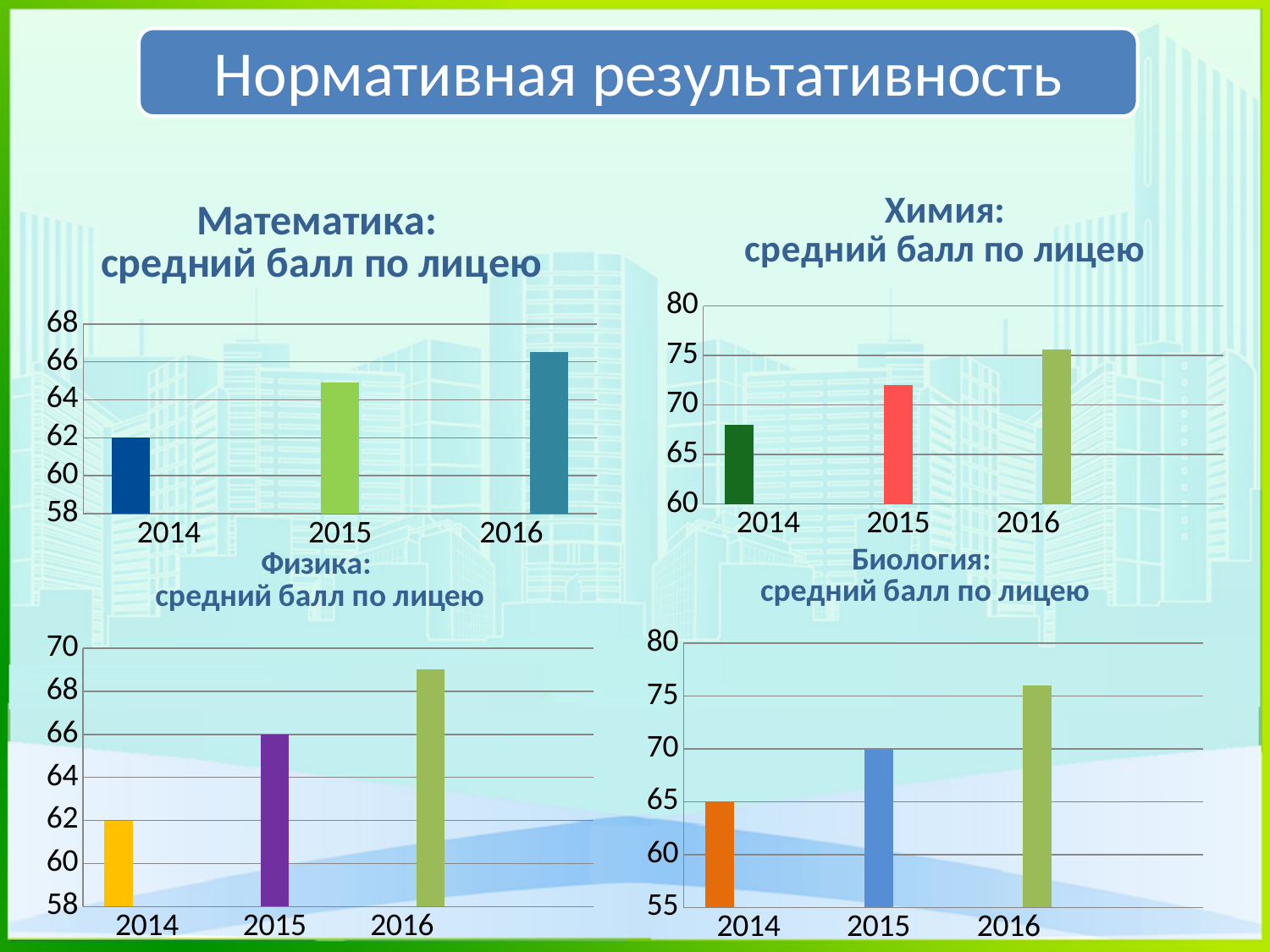
On the chart titled "Биология: средний балл по лицею", do the values rise or fall from 2014 to 2016? rise On the chart titled "Биология: средний балл по лицею", what is the difference between the values for 2015 and 2014? 5 On the chart titled "Биология: средний балл по лицею", what is the value for 2014? 65 On the chart titled "Математика: средний балл по лицею", is the value for 2016 greater or less than 66? greater On the chart titled "Физика: средний балл по лицею", which year has the lowest value? 2014 How many years are shown on the chart titled "Математика: средний балл по лицею"? 3 On the chart titled "Биология: средний балл по лицею", what is the value for 2015? 70 On the chart titled "Химия: средний балл по лицею", which year has the highest value? 2016 On the chart titled "Математика: средний балл по лицею", what is the value for 2014? 62 On the chart titled "Физика: средний балл по лицею", what is the value for 2015? 66 On the chart titled "Физика: средний балл по лицею", what is the difference between the values for 2015 and 2014? 4